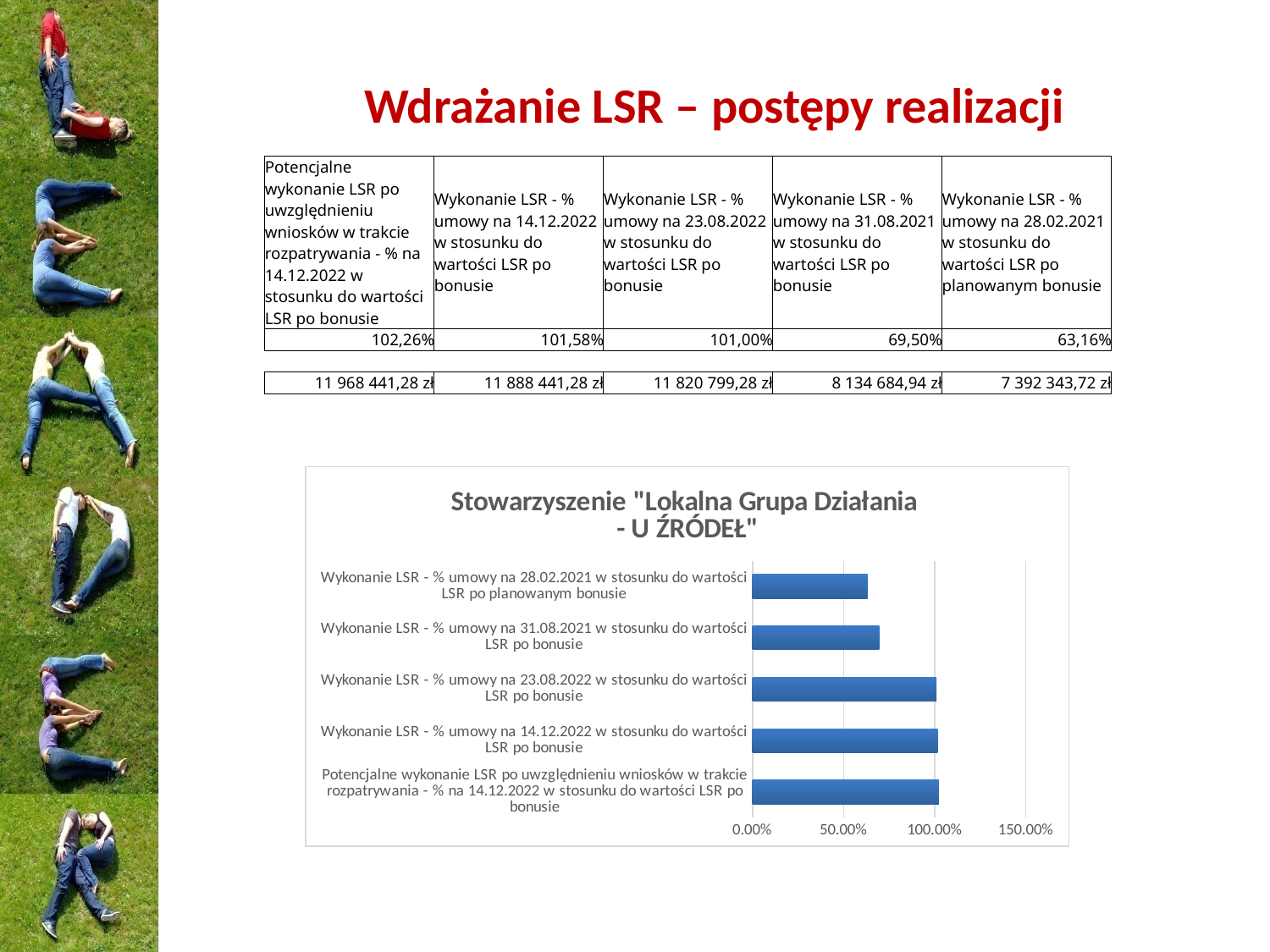
What kind of chart is shown on the slide? Bar chart What is the title of the chart? Stowarzyszenie "Lokalna Grupa Działania - U ŹRÓDEŁ" Is the value for "Wykonanie LSR - % umowy na 23.08.2022 w stosunku do wartości LSR po bonusie" greater or less than 50.00%? greater Which is larger: the value for "Wykonanie LSR - % umowy na 28.02.2021 w stosunku do wartości LSR po planowanym bonusie" or the value for "Wykonanie LSR - % umowy na 14.12.2022 w stosunku do wartości LSR po bonusie"? Wykonanie LSR - % umowy na 14.12.2022 w stosunku do wartości LSR po bonusie Which is larger: the value for "Wykonanie LSR - % umowy na 31.08.2021 w stosunku do wartości LSR po bonusie" or the value for "Wykonanie LSR - % umowy na 23.08.2022 w stosunku do wartości LSR po bonusie"? Wykonanie LSR - % umowy na 23.08.2022 w stosunku do wartości LSR po bonusie Is the value for "Wykonanie LSR - % umowy na 28.02.2021 w stosunku do wartości LSR po planowanym bonusie" greater or less than 100.00%? less How many categories (bars) does the chart show? 5 What is the highest value shown on the chart's horizontal axis? 150.00% Is the value for "Potencjalne wykonanie LSR po uwzględnieniu wniosków w trakcie rozpatrywania - % na 14.12.2022 w stosunku do wartości LSR po bonusie" greater or less than 50.00%? greater Which category has the lowest value in the chart? Wykonanie LSR - % umowy na 28.02.2021 w stosunku do wartości LSR po planowanym bonusie